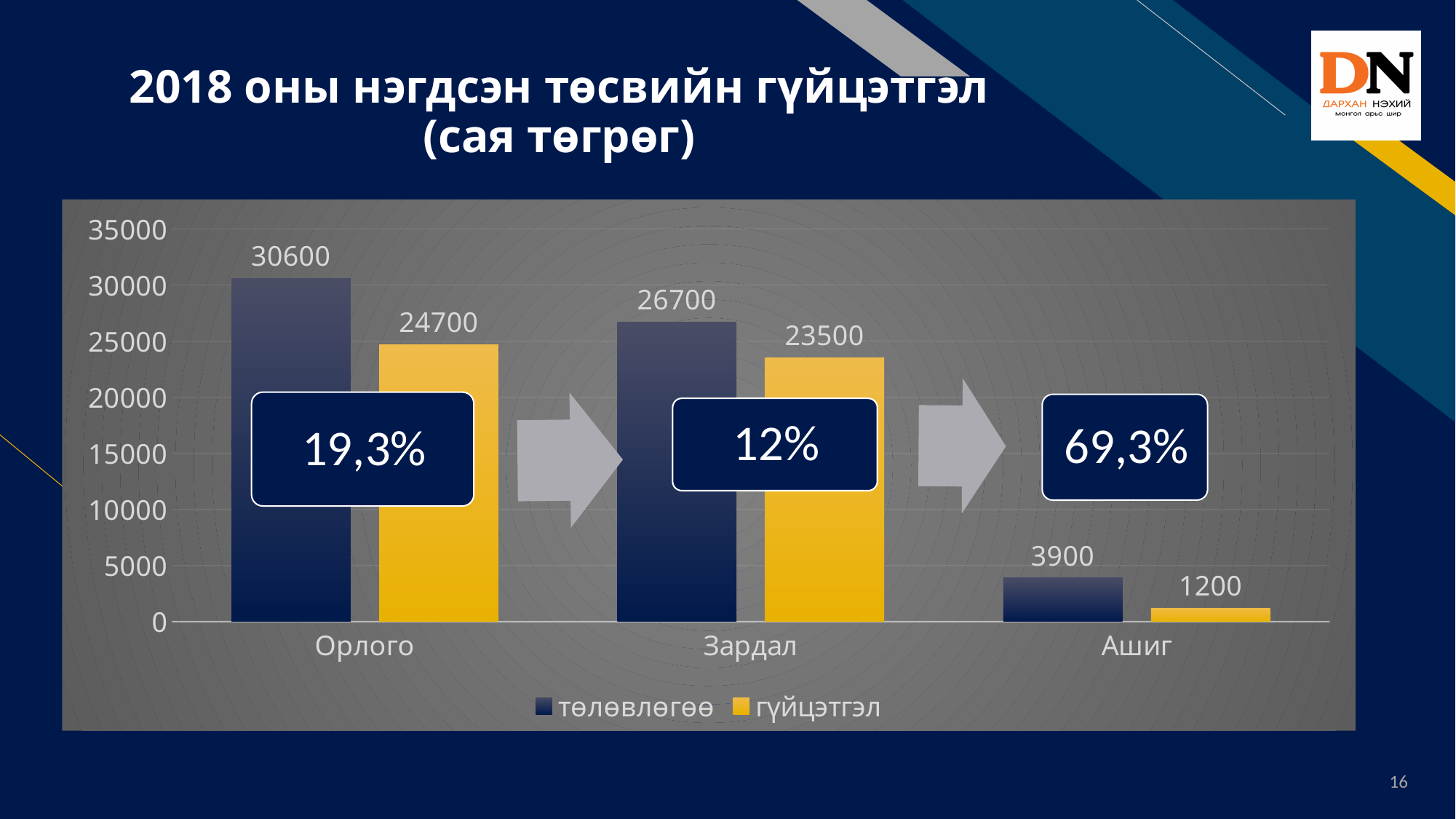
How many categories are shown on the x axis? 3 What is the difference between the төлөвлөгөө and гүйцэтгэл values for Орлого? 5900 What is the гүйцэтгэл value for Зардал? 23500 Which is larger for Зардал: the төлөвлөгөө value or the гүйцэтгэл value? төлөвлөгөө What kind of chart is shown on the slide? Bar chart How many series does the legend list? 2 Which category has the highest төлөвлөгөө value? Орлого What is the difference between the төлөвлөгөө and гүйцэтгэл values for Ашиг? 2700 Which category has the lowest гүйцэтгэл value? Ашиг What percentage is shown in the box above the Ашиг bars? 69,3% What is the төлөвлөгөө value for Орлого? 30600 What is the гүйцэтгэл value for Ашиг? 1200